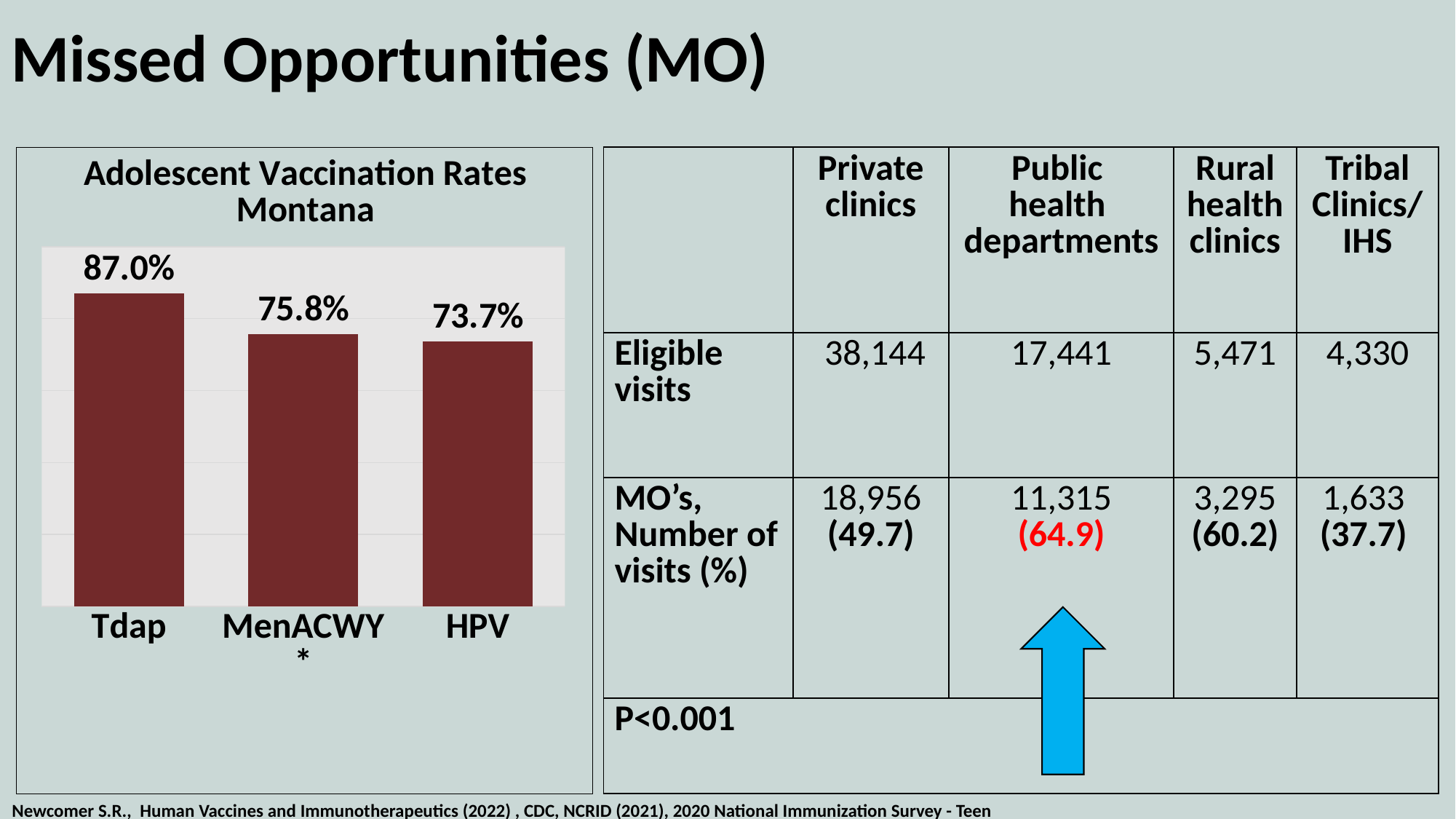
What is the title of the bar chart on the slide? Adolescent Vaccination Rates Montana What is the vaccination rate for Tdap in the Adolescent Vaccination Rates Montana chart? 87.0% What is the difference between the Tdap and HPV vaccination rates in the Adolescent Vaccination Rates Montana chart? 13.3% What is the vaccination rate for HPV in the Adolescent Vaccination Rates Montana chart? 73.7% In the Adolescent Vaccination Rates Montana chart, which is larger, the rate for MenACWY or the rate for HPV? MenACWY What is the vaccination rate for MenACWY in the Adolescent Vaccination Rates Montana chart? 75.8% Do the vaccination rates rise or fall from left to right across the Adolescent Vaccination Rates Montana chart? Fall What is the difference between the Tdap and MenACWY vaccination rates in the Adolescent Vaccination Rates Montana chart? 11.2% Which vaccine has the lowest vaccination rate in the Adolescent Vaccination Rates Montana chart? HPV What kind of chart is the Adolescent Vaccination Rates Montana chart? Bar chart Which vaccine has the highest vaccination rate in the Adolescent Vaccination Rates Montana chart? Tdap How many vaccines are shown in the Adolescent Vaccination Rates Montana chart? 3